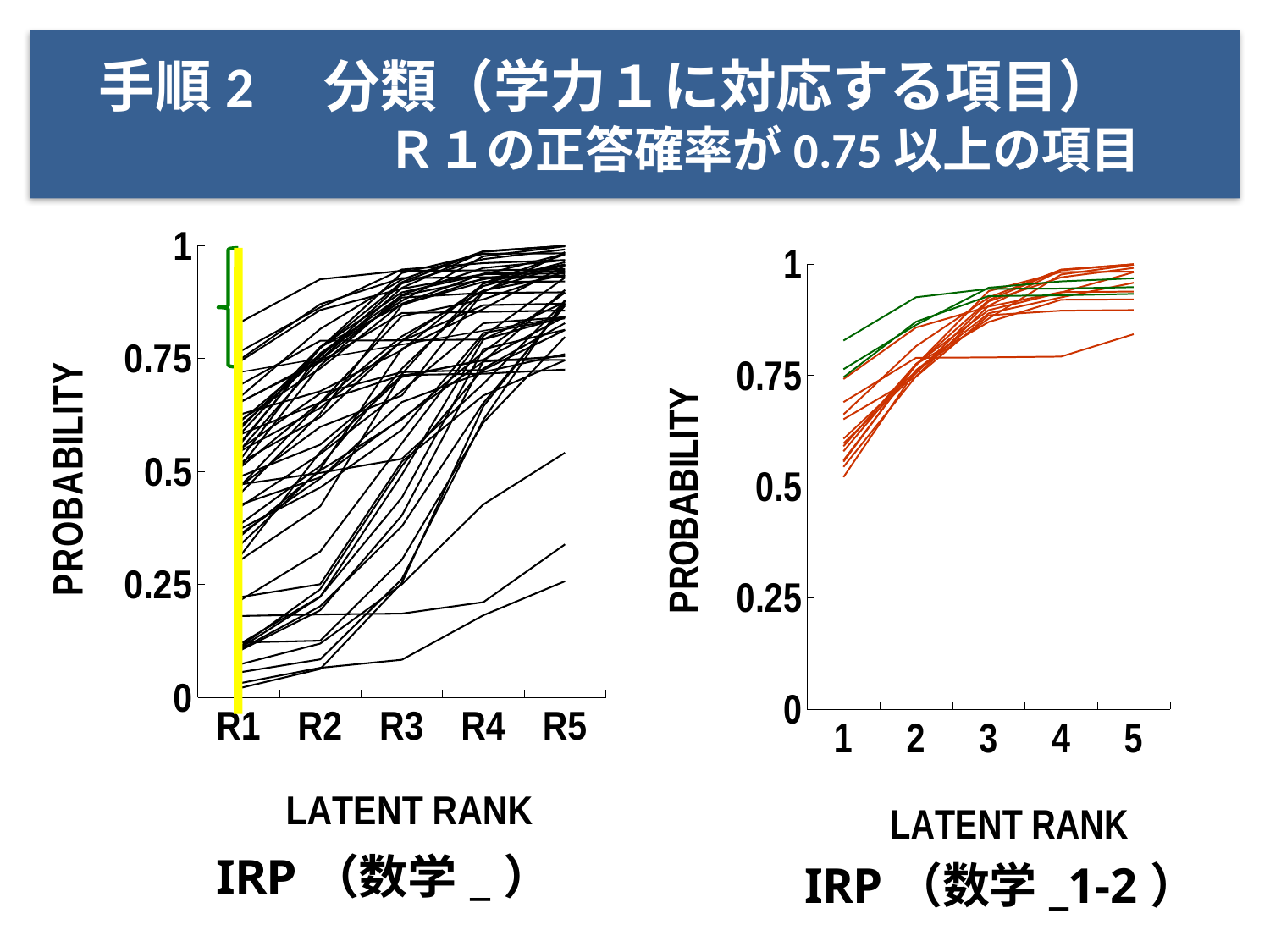
In the left chart "IRP (数学_)", what is the label of the y axis? PROBABILITY In the left chart "IRP (数学_)", do the lines generally rise or fall from R1 to R5? rise What kind of chart is the left chart titled "IRP (数学_)"? line chart In the right chart "IRP (数学_1-2)", are the values of all lines at latent rank 5 greater or less than 0.75? greater In the right chart "IRP (数学_1-2)", do the lines generally rise or fall from latent rank 1 to latent rank 5? rise In the right chart "IRP (数学_1-2)", how many latent rank categories are shown on the x axis? 5 What kind of chart is the right chart titled "IRP (数学_1-2)"? line chart In the left chart "IRP (数学_)", what is the highest tick value shown on the y axis? 1 In the left chart "IRP (数学_)", how many latent rank categories are shown on the x axis? 5 In the left chart "IRP (数学_)", what is the label of the first category on the x axis? R1 In the right chart "IRP (数学_1-2)", what is the label of the x axis? LATENT RANK